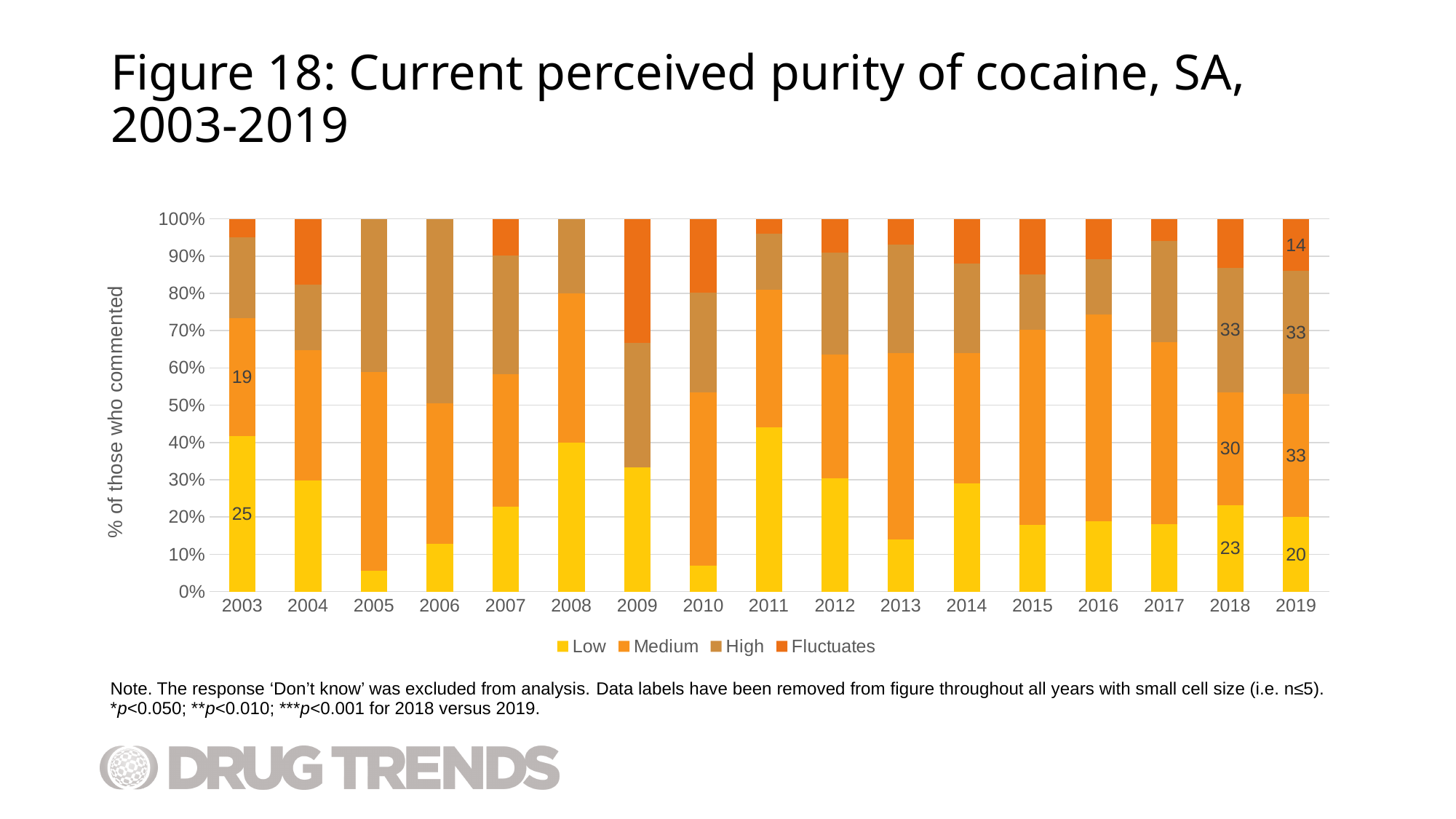
What is the difference between the labelled Low values for 2018 and 2019? 3 What are the four legend entries of the chart? Low, Medium, High, Fluctuates In 2003, which is larger, the labelled Low value or the labelled Medium value? Low What kind of chart is shown on the slide? Stacked bar chart What is the labelled value for Low in 2003? 25 What is the labelled value for Medium in 2018? 30 What is the labelled value for Fluctuates in 2019? 14 How many series does the legend list? 4 How many years are shown along the x axis of the chart? 17 Which year has the larger labelled Medium value, 2018 or 2019? 2019 What is the labelled value for Low in 2019? 20 Is the Low segment for 2010 greater or less than 10%? less